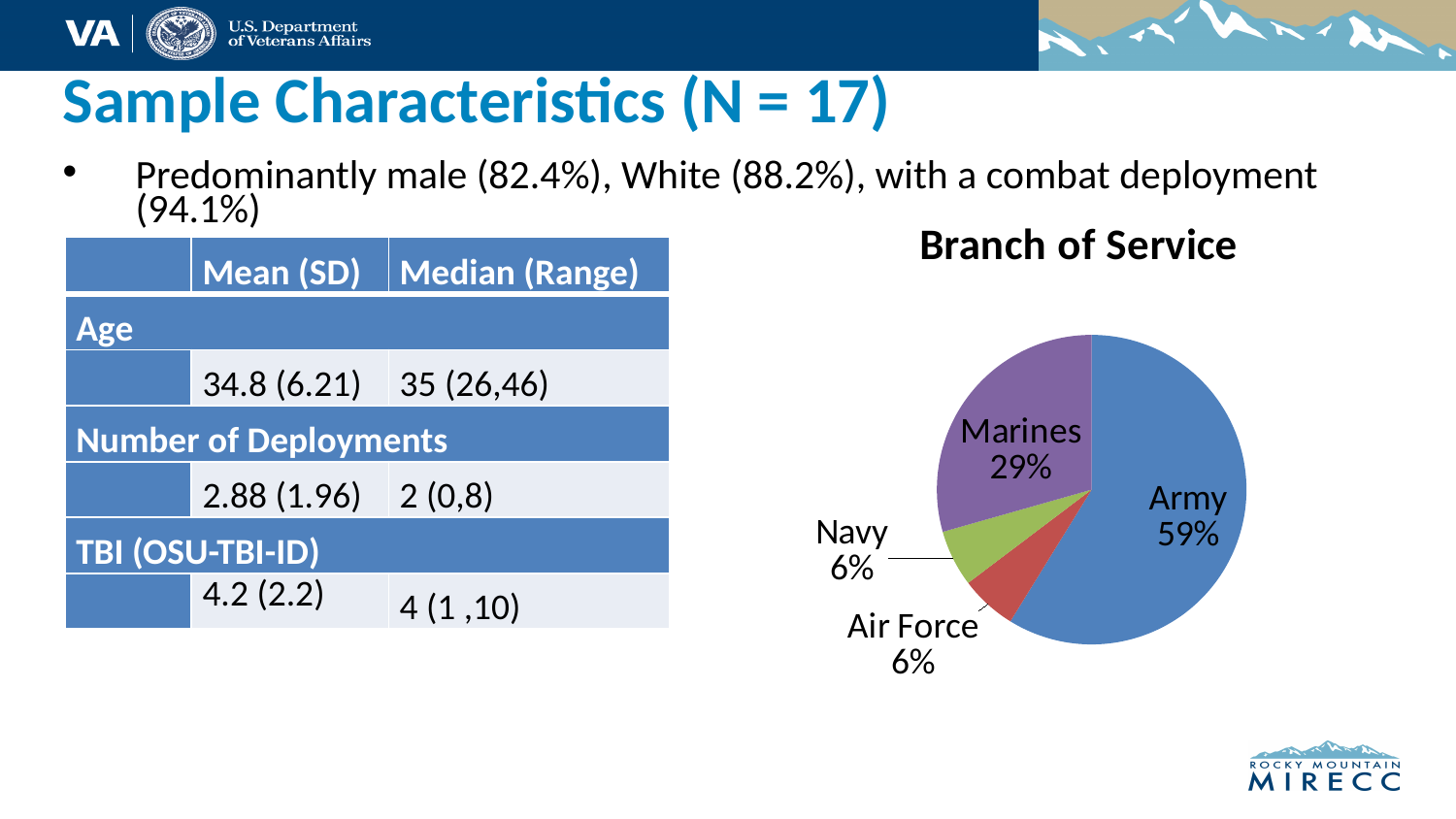
What share of the Branch of Service pie is Army? 59% What is the difference in percentage points between the Marines and Air Force slices? 23 What is the title of the pie chart? Branch of Service Which slice is larger, Marines or Navy? Marines What type of chart is shown on the slide? pie chart How many slices does the Branch of Service pie chart have? 4 What share of the Branch of Service pie is Navy? 6% Which slice is larger, Army or Marines? Army What share of the Branch of Service pie is Marines? 29% Which branch of service has the largest slice of the pie? Army What is the difference in percentage points between the Army and Marines slices? 30